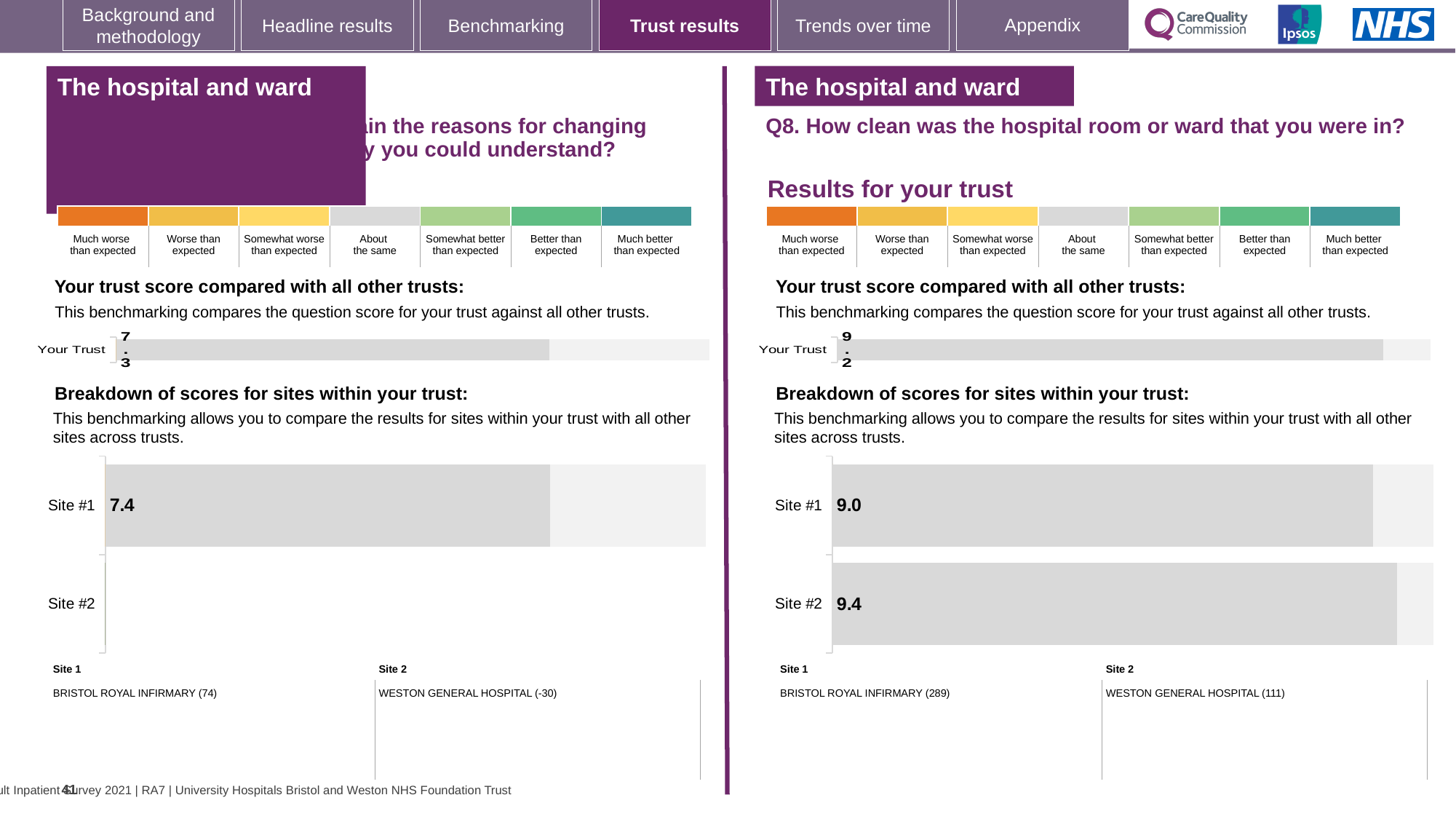
On the left-hand side of the slide, how many sites are listed in the breakdown of scores for sites within your trust? 2 On the left-hand side of the slide, what is the score for Site #1 in the breakdown of scores for sites within your trust? 7.4 Comparing the Your Trust scores on the two halves of the slide, which is higher: the left-hand chart or the right-hand chart (Q8)? The right-hand chart (Q8) On the left-hand side of the slide, what is the score shown for Your Trust? 7.3 On the right-hand side of the slide (Q8, how clean was the hospital room or ward), what is the score shown for Your Trust? 9.2 On the left-hand side of the slide, which hospital is listed as Site 2? WESTON GENERAL HOSPITAL (-30) On the right-hand side of the slide (Q8), which site has the higher score, Site #1 or Site #2? Site #2 On the right-hand side of the slide (Q8), which hospital is listed as Site 1? BRISTOL ROYAL INFIRMARY (289) On the right-hand side of the slide (Q8), what is the score for Site #2 in the breakdown of scores for sites within your trust? 9.4 On the right-hand side of the slide (Q8), what is the difference between the Site #2 score and the Site #1 score? 0.4 What kind of chart is used to show the breakdown of scores for sites within your trust on the right-hand side of the slide? Bar chart On the right-hand side of the slide (Q8), what is the score for Site #1 in the breakdown of scores for sites within your trust? 9.0